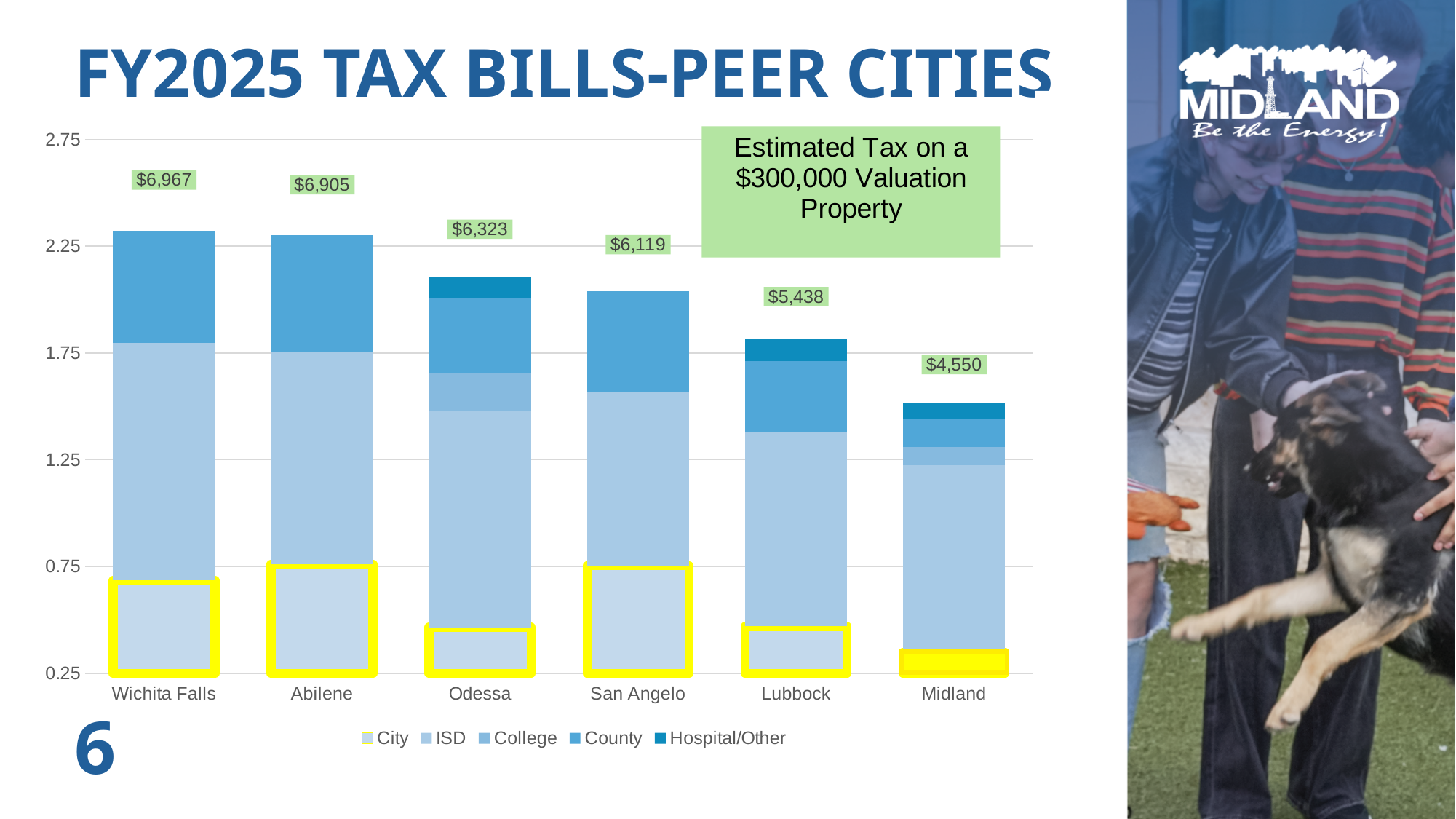
What is the estimated tax label shown for Midland? $4,550 What is the estimated tax label shown for Lubbock? $5,438 Do the estimated tax bills rise or fall moving from left to right across the cities? Fall Which city has the lowest estimated tax bill? Midland Which city has the highest estimated tax bill? Wichita Falls What is the estimated tax label shown for Odessa? $6,323 Which has a larger estimated tax bill, San Angelo or Lubbock? San Angelo How many series does the legend list? 5 How many cities are shown on the x axis? 6 Is the total stacked bar height for Midland greater or less than 1.75? less What is the difference between the estimated tax for Wichita Falls and Midland? $2,417 What kind of chart is shown on the slide? Stacked bar chart